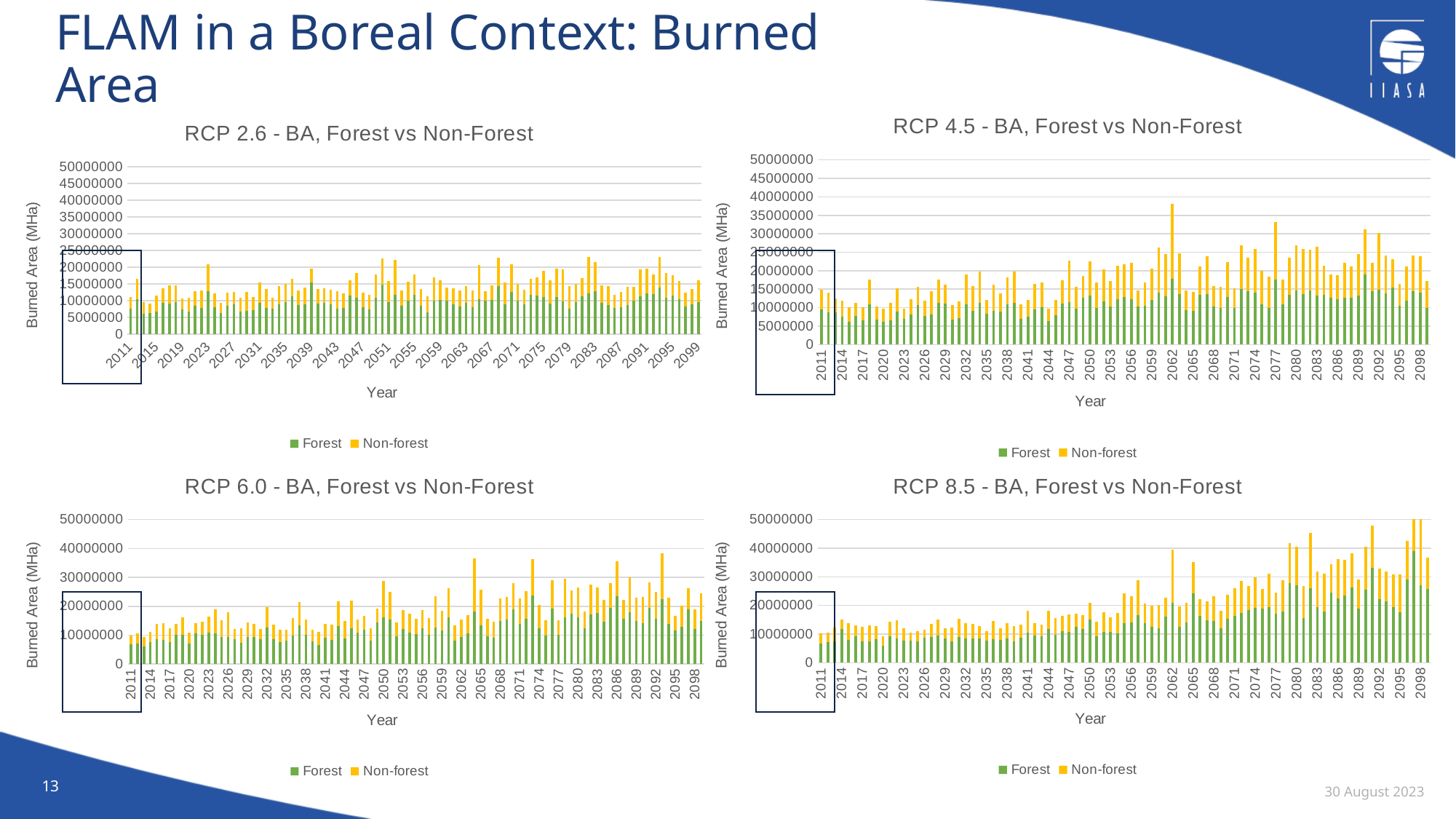
How many series does the legend of the 'RCP 8.5 - BA, Forest vs Non-Forest' chart list? 2 In the 'RCP 8.5 - BA, Forest vs Non-Forest' chart, does the total burned area generally rise or fall from 2011 to 2098? Rise In the 'RCP 4.5 - BA, Forest vs Non-Forest' chart, which year has the highest total burned area? 2062 In the 'RCP 4.5 - BA, Forest vs Non-Forest' chart, is the total burned area for 2062 greater or less than 30000000? greater What kind of chart is the 'RCP 2.6 - BA, Forest vs Non-Forest' chart? Stacked bar chart In the 'RCP 6.0 - BA, Forest vs Non-Forest' chart, is the total burned area for 2092 greater or less than 30000000? less How many charts are shown on the slide? 4 In the 'RCP 8.5 - BA, Forest vs Non-Forest' chart, is the total burned area for 2098 greater or less than 40000000? greater In the 'RCP 4.5 - BA, Forest vs Non-Forest' chart, what are the two series named in the legend? Forest and Non-forest What is the y-axis label of the 'RCP 6.0 - BA, Forest vs Non-Forest' chart? Burned Area (MHa)